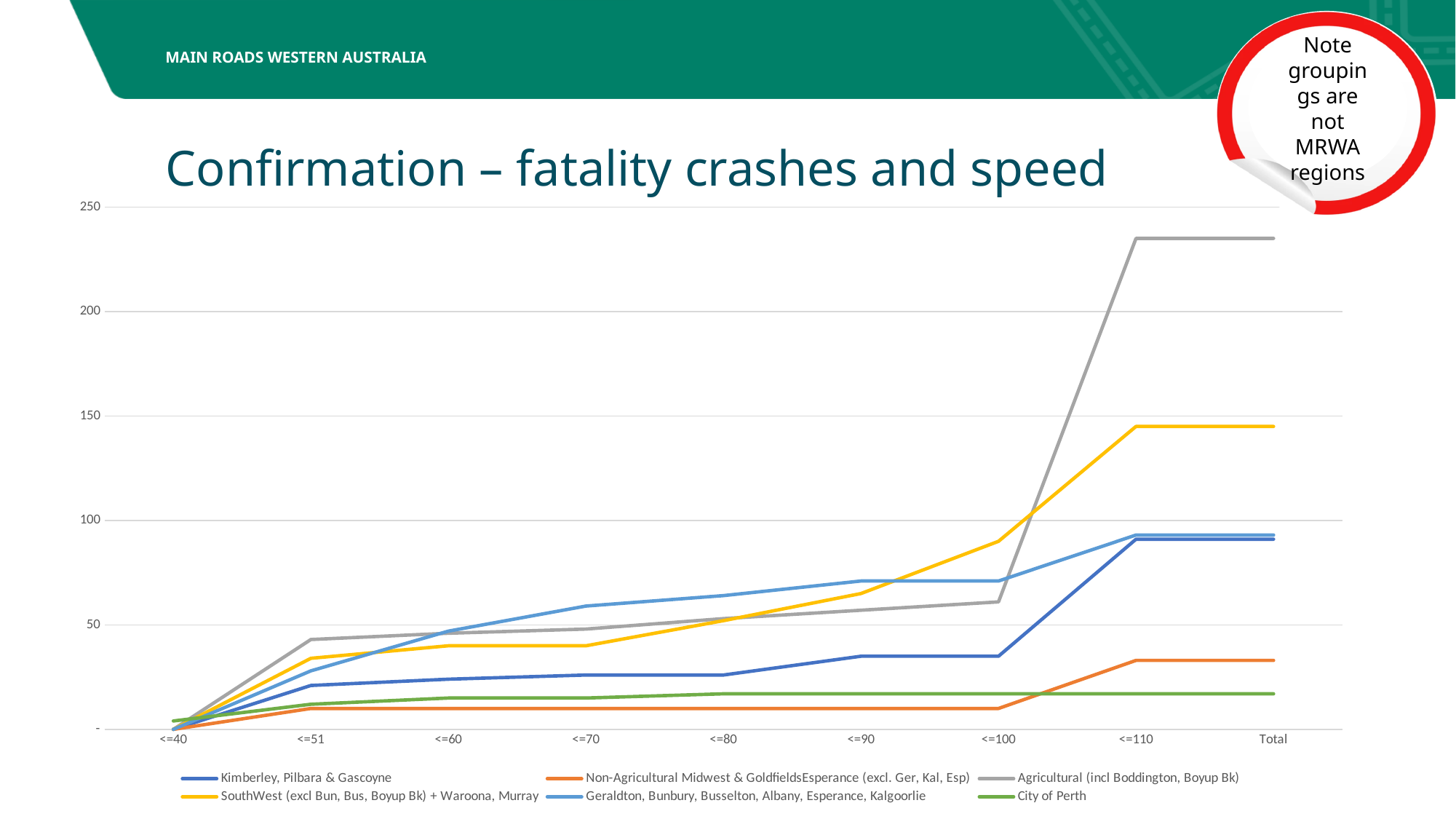
Is the value for Agricultural (incl Boddington, Boyup Bk) at Total greater or less than 200? greater What kind of chart is shown on the slide? Line chart Is the value for City of Perth at Total greater or less than 50? less How many series does the legend list? 6 Which series has the highest value at the Total category? Agricultural (incl Boddington, Boyup Bk) Does the Agricultural (incl Boddington, Boyup Bk) line rise or fall from <=40 to <=110? Rise Which series has the lowest value at <=100? Non-Agricultural Midwest & GoldfieldsEsperance (excl. Ger, Kal, Esp) Is the value for Geraldton, Bunbury, Busselton, Albany, Esperance, Kalgoorlie at <=100 greater or less than 50? greater How many categories are shown along the x axis? 9 What is the title of the chart? Confirmation – fatality crashes and speed Which series has the lowest value at the Total category? City of Perth At the Total category, which is larger: SouthWest (excl Bun, Bus, Boyup Bk) + Waroona, Murray or Geraldton, Bunbury, Busselton, Albany, Esperance, Kalgoorlie? SouthWest (excl Bun, Bus, Boyup Bk) + Waroona, Murray